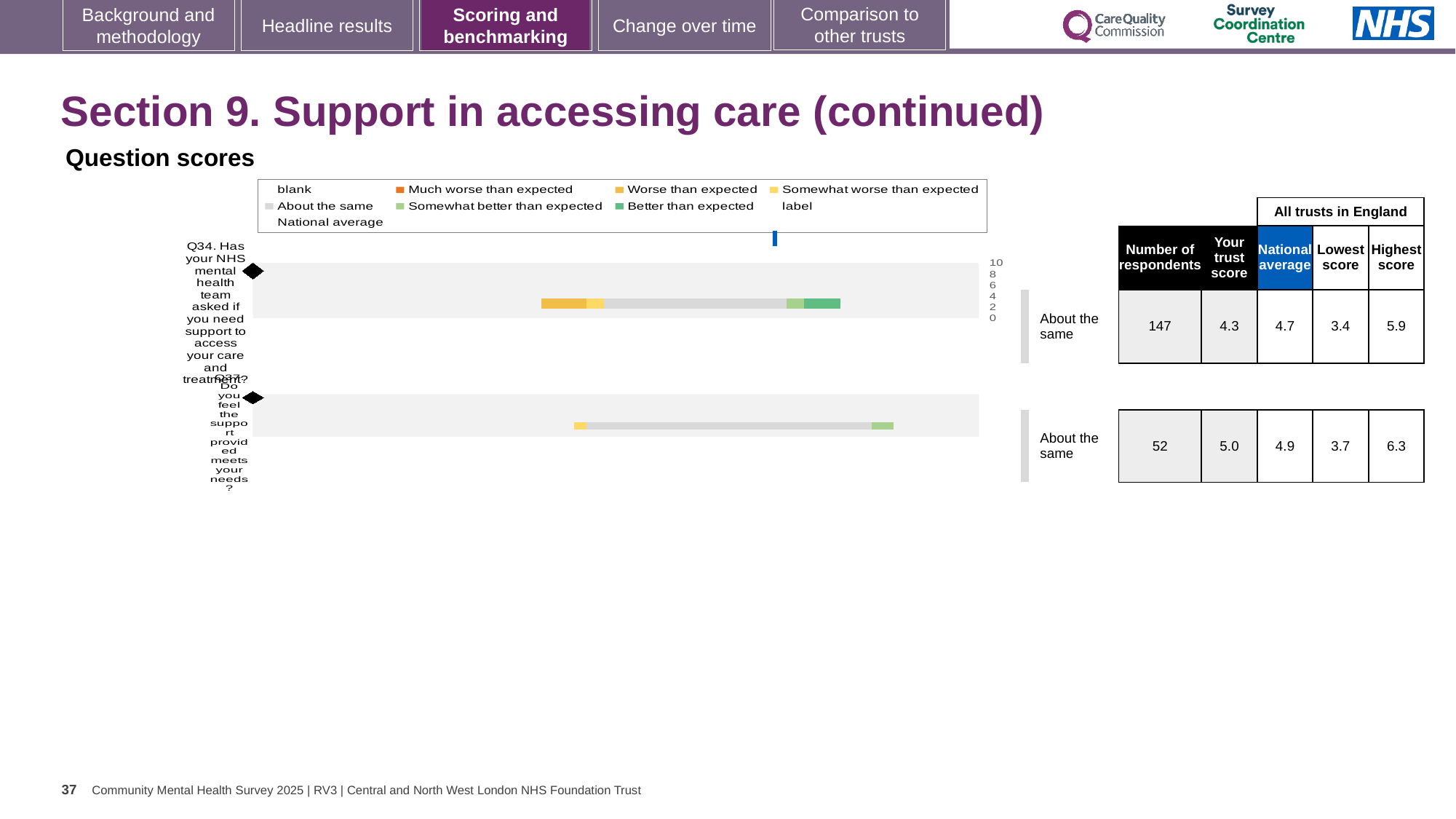
In the question scores chart legend, which entry is shown in orange? Much worse than expected What is the number of respondents for Q34 in the question scores table? 147 In the question scores chart legend, which entry is shown in grey? About the same What is the difference between the highest score and the lowest score for Q37? 2.6 What benchmark category is shown for Q34? About the same What type of chart is used to show the question scores on this slide? bar chart What is the highest score among all trusts in England for Q34? 5.9 What is the national average for Q34 in the question scores table? 4.7 For Q34, which is larger: your trust score or the national average? National average How many questions are plotted in the question scores chart? 2 Which question has the higher trust score, Q34 or Q37? Q37 What is your trust score for Q37 in the question scores table? 5.0